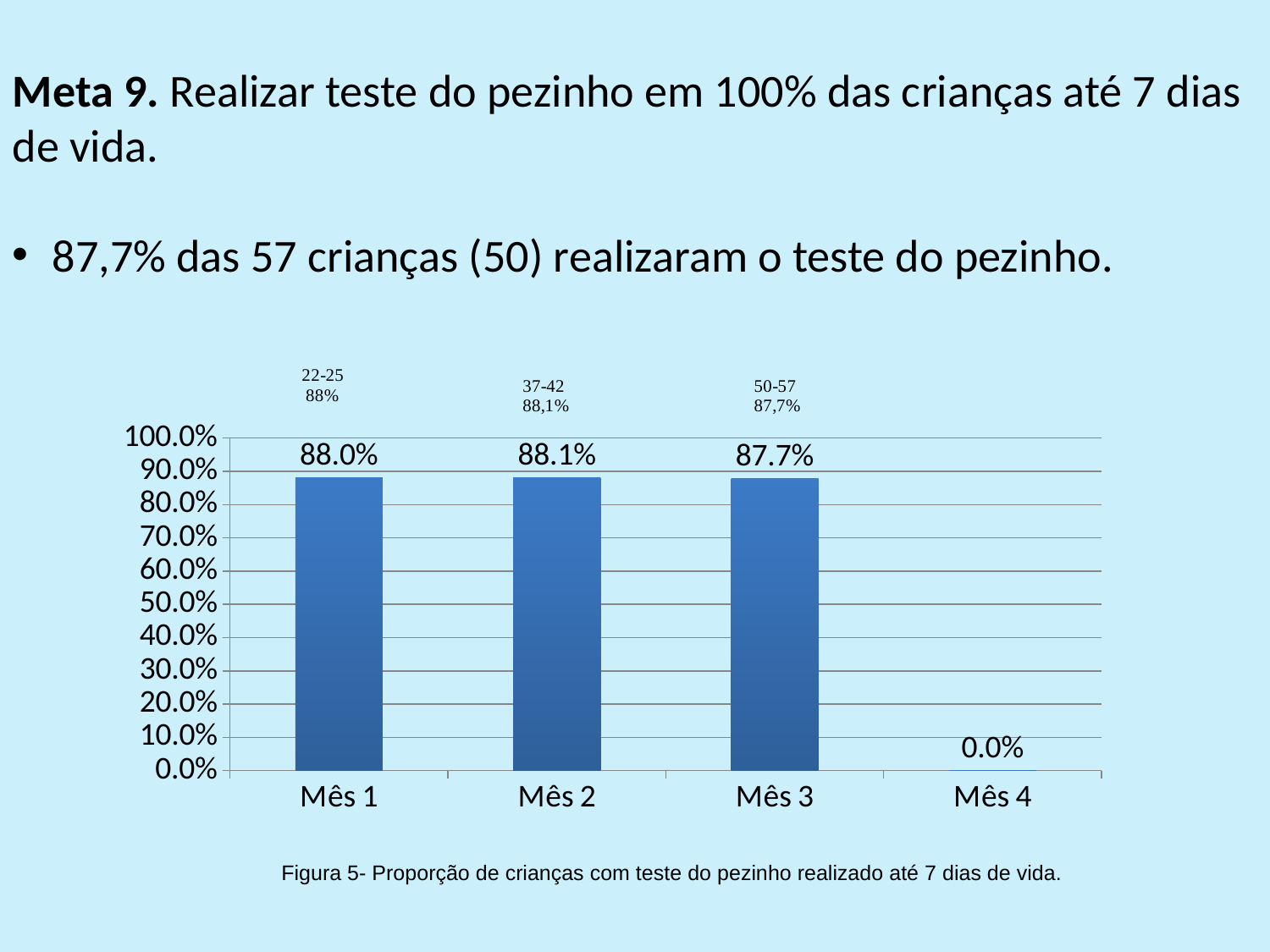
Which month has the lowest value? Mês 4 What is the value for Mês 3? 87.7% Is the value for Mês 3 greater or less than 80.0%? greater What is the difference between the values for Mês 2 and Mês 3? 0.4% What is the value for Mês 4? 0.0% How many months are shown on the x axis? 4 What is the figure caption below the chart? Figura 5- Proporção de crianças com teste do pezinho realizado até 7 dias de vida. Which is larger, the value for Mês 1 or the value for Mês 4? Mês 1 What kind of chart is shown on the slide? bar chart Do the values rise or fall from Mês 3 to Mês 4? fall Which month has the highest value according to the data labels? Mês 2 What is the value for Mês 1? 88.0%